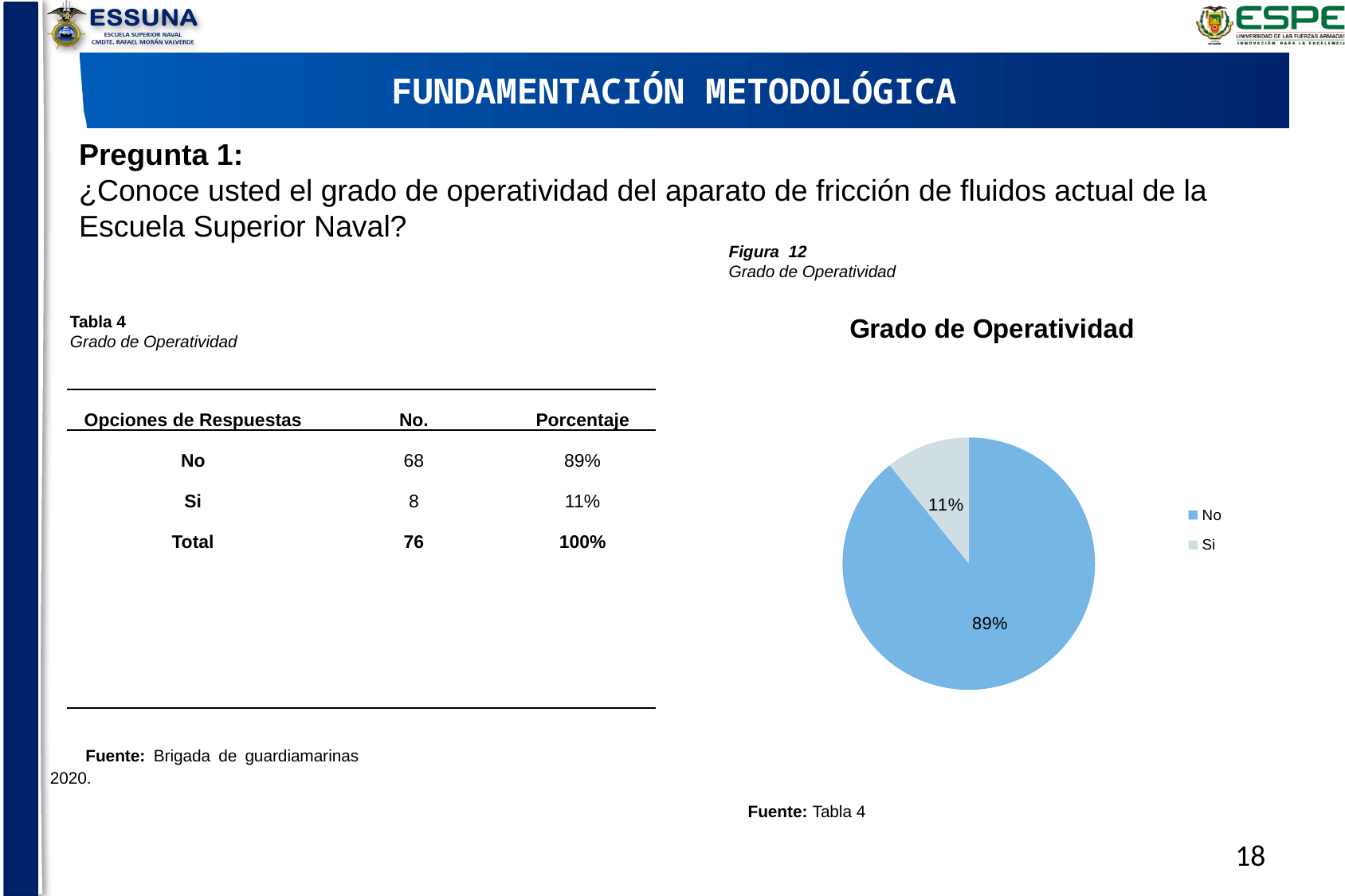
What share of the pie does the "Si" slice represent? 11% What type of chart is shown on the slide? pie chart Which legend entry is shown in the darker blue colour? No Which category has the smallest slice in the pie chart? Si What percentage does the "No" slice show in the pie chart? 89% How many slices does the pie chart have? 2 What is the difference in percentage points between the "No" slice and the "Si" slice? 78 What is the title of the chart? Grado de Operatividad Which slice is larger, "No" or "Si"? No How many entries does the legend of the pie chart list? 2 Which category has the largest slice in the pie chart? No What percentage does the "Si" slice show in the pie chart? 11%